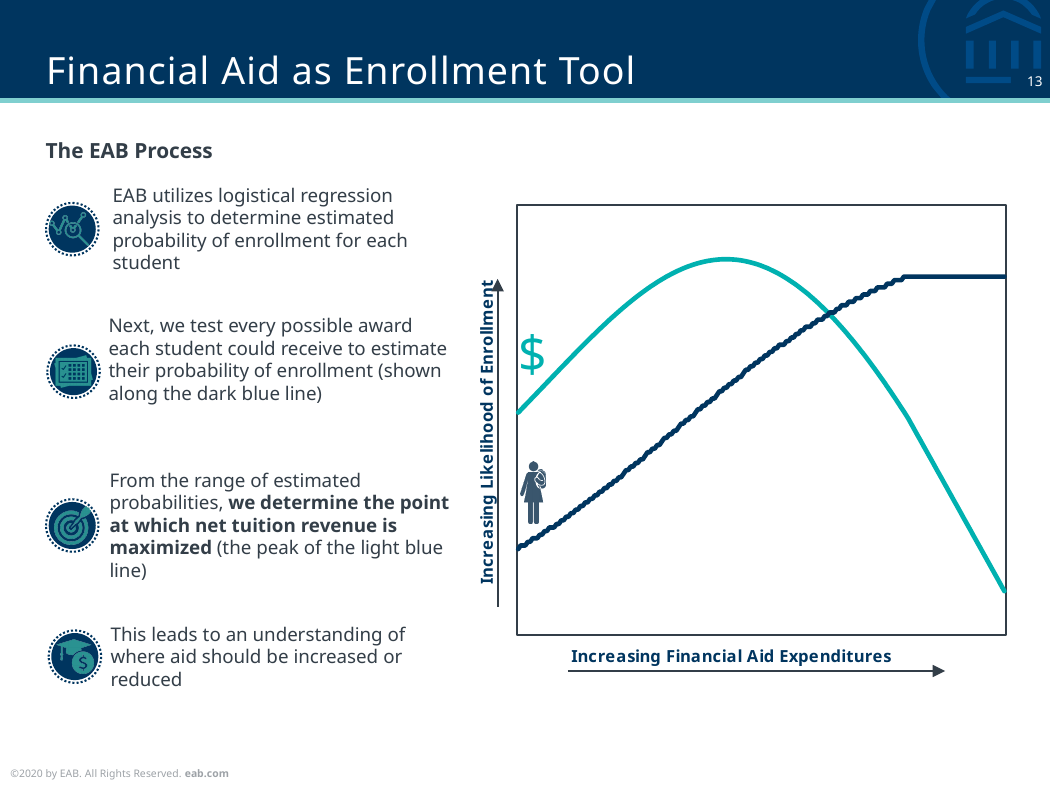
What is the label on the vertical axis of the chart? Increasing Likelihood of Enrollment How many lines are plotted on the chart? 2 Which line on the chart reaches a peak and then declines? The light blue line Does the dark blue line rise or fall as financial aid expenditures increase? Rises, then levels off What kind of chart is shown on the slide? Line chart At the right edge of the chart, which line ends higher, the dark blue line or the light blue line? The dark blue line At the left edge of the chart, which line starts higher, the dark blue line or the light blue line? The light blue line Does the light blue line rise or fall toward the right end of the x axis? Falls What is the label on the horizontal axis of the chart? Increasing Financial Aid Expenditures